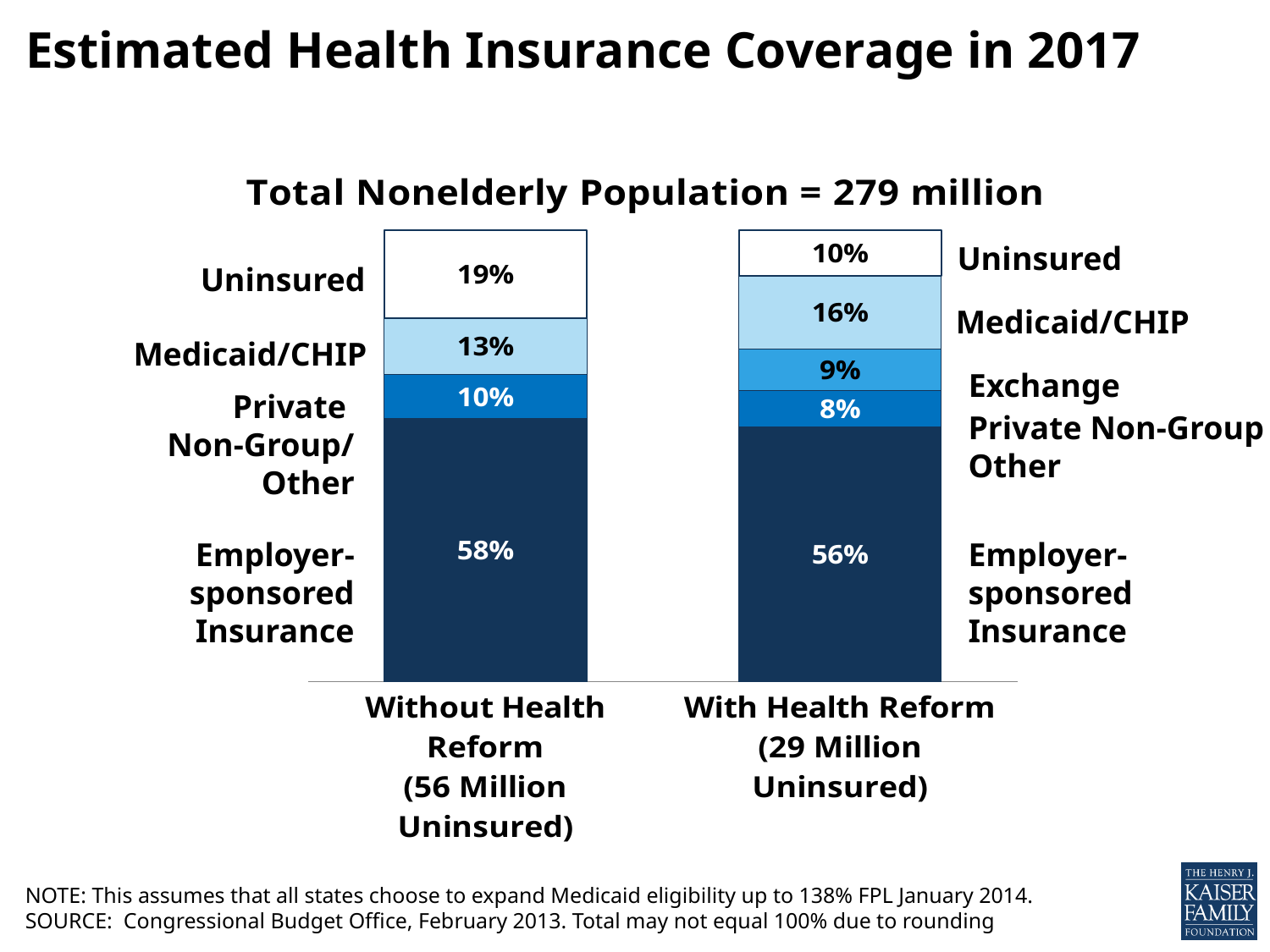
By how many percentage points does the uninsured share fall from without health reform to with health reform? 9 percentage points What is the Exchange share with health reform? 9% Which coverage segment is the smallest in the With Health Reform bar? Private Non-Group/Other How many bars does the chart show? 2 Which coverage segment is the largest in the Without Health Reform bar? Employer-sponsored Insurance What share of the nonelderly population is uninsured with health reform? 10% What is the total nonelderly population stated in the chart title? 279 million What is the Employer-sponsored Insurance share without health reform? 58% What kind of chart is shown on the slide? Stacked bar chart What share of the nonelderly population is uninsured without health reform? 19% Is the Medicaid/CHIP share larger without health reform or with health reform? With health reform What is the Medicaid/CHIP share with health reform? 16%